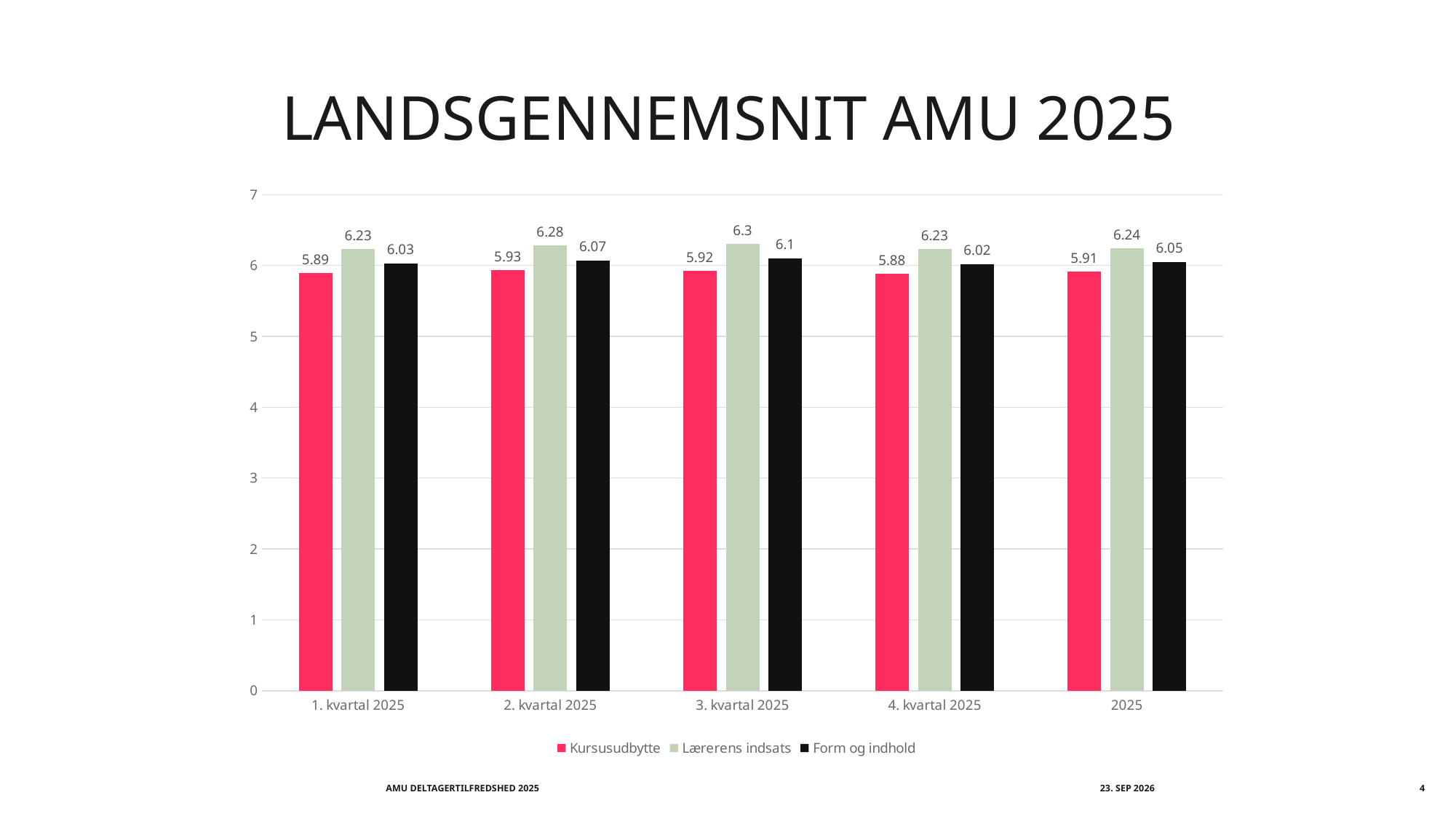
What is the value for Kursusudbytte in 1. kvartal 2025? 5.89 In which category is Kursusudbytte lowest? 4. kvartal 2025 Which is larger: Form og indhold in 2. kvartal 2025 or Form og indhold in 4. kvartal 2025? 2. kvartal 2025 What is the value for Form og indhold in 3. kvartal 2025? 6.1 What is the value for Lærerens indsats in 2. kvartal 2025? 6.28 How many categories are shown on the x axis? 5 What is the value for Lærerens indsats for 2025? 6.24 How many series does the legend list? 3 In which category does Lærerens indsats reach its highest value? 3. kvartal 2025 What is the difference between Lærerens indsats and Kursusudbytte in 3. kvartal 2025? 0.38 What kind of chart is shown on the slide? bar chart Is the value for Kursusudbytte in 2. kvartal 2025 greater or less than 6? less